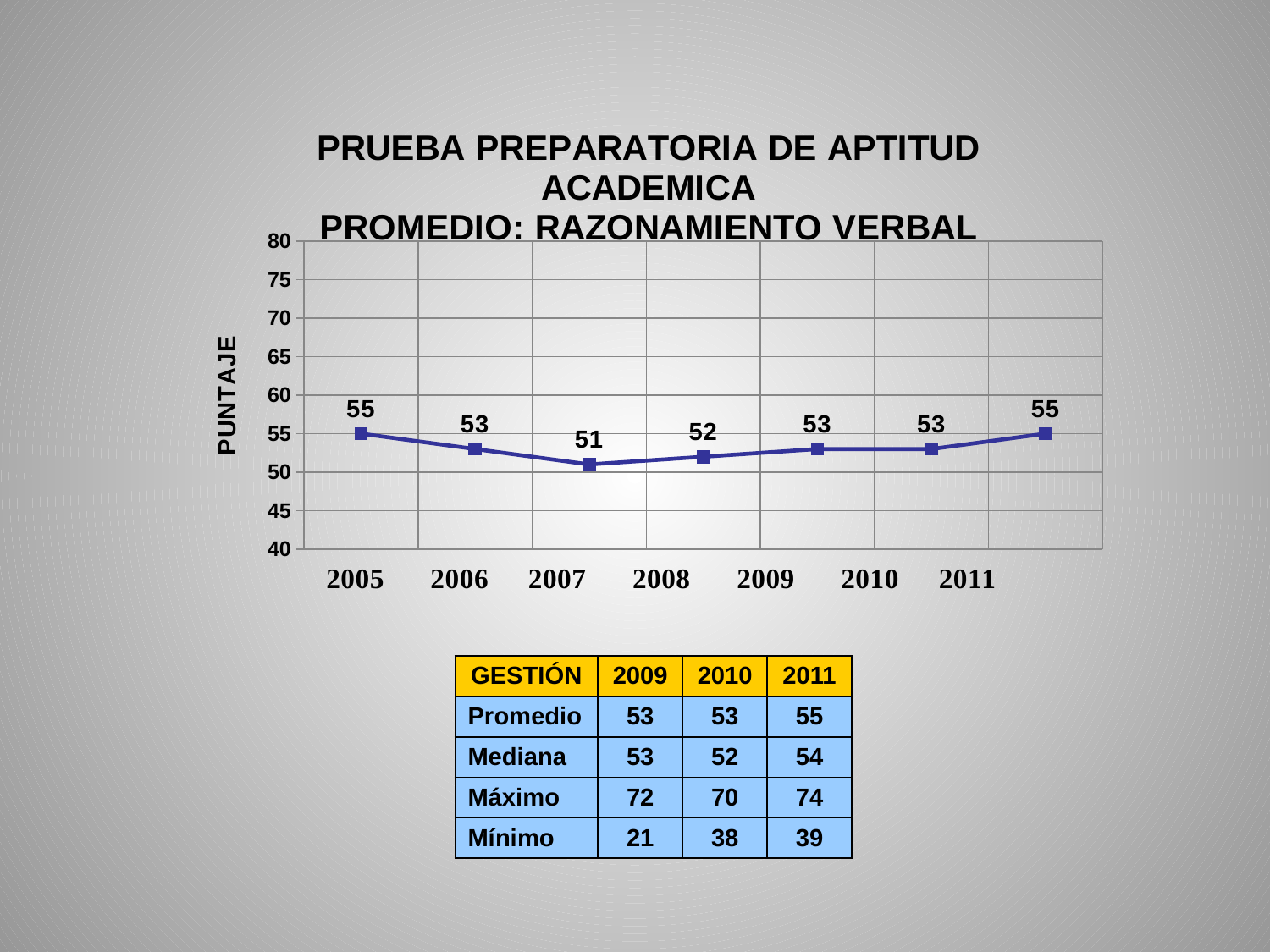
Which year has the lowest value? 2007 What is the label of the y axis? PUNTAJE What is the value for 2008? 52 What is the value for 2005? 55 What is the difference between the values for 2005 and 2007? 4 What type of chart is shown on the slide? line chart What is the difference between the values for 2011 and 2009? 2 Which is larger, the value for 2011 or the value for 2010? 2011 What is the value for 2007? 51 How many years are plotted on the x axis? 7 Is the value for 2007 greater or less than 60? less Do the values rise or fall from 2007 to 2011? rise